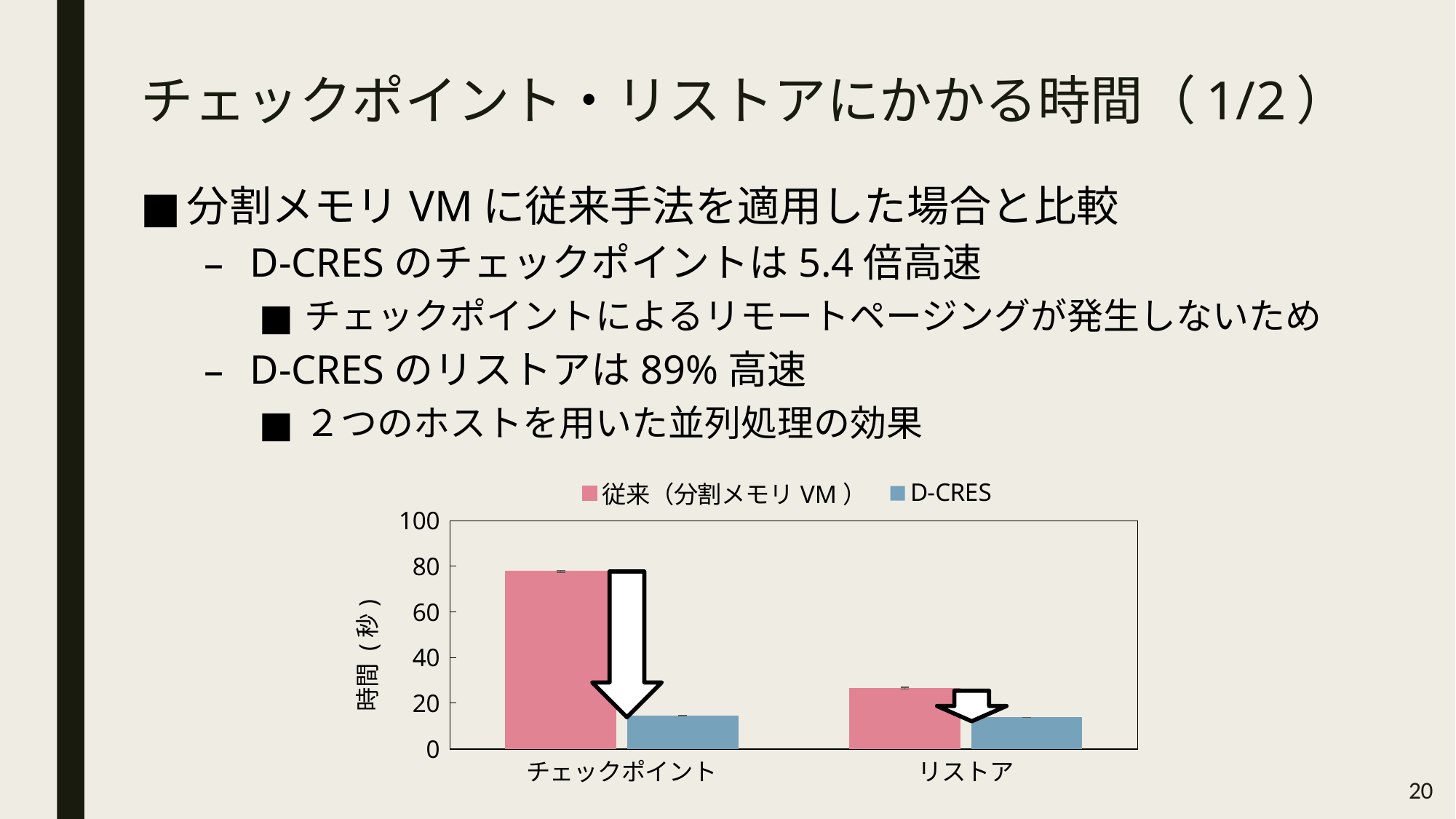
Is the value for D-CRES at リストア greater or less than 40? less For リストア, which series has the larger value: 従来（分割メモリ VM） or D-CRES? 従来（分割メモリ VM） Is the value for D-CRES at チェックポイント greater or less than 20? less What is the label of the y axis of the chart? 時間（秒） Is the value for 従来（分割メモリ VM） at リストア greater or less than 20? greater How many categories are shown on the x axis of the chart? 2 How many series does the chart legend list? 2 What kind of chart is shown on the slide? bar chart For チェックポイント, which series has the larger value: 従来（分割メモリ VM） or D-CRES? 従来（分割メモリ VM） Which series and category has the tallest bar in the chart? 従来（分割メモリ VM）, チェックポイント Which series is shown in blue in the chart? D-CRES